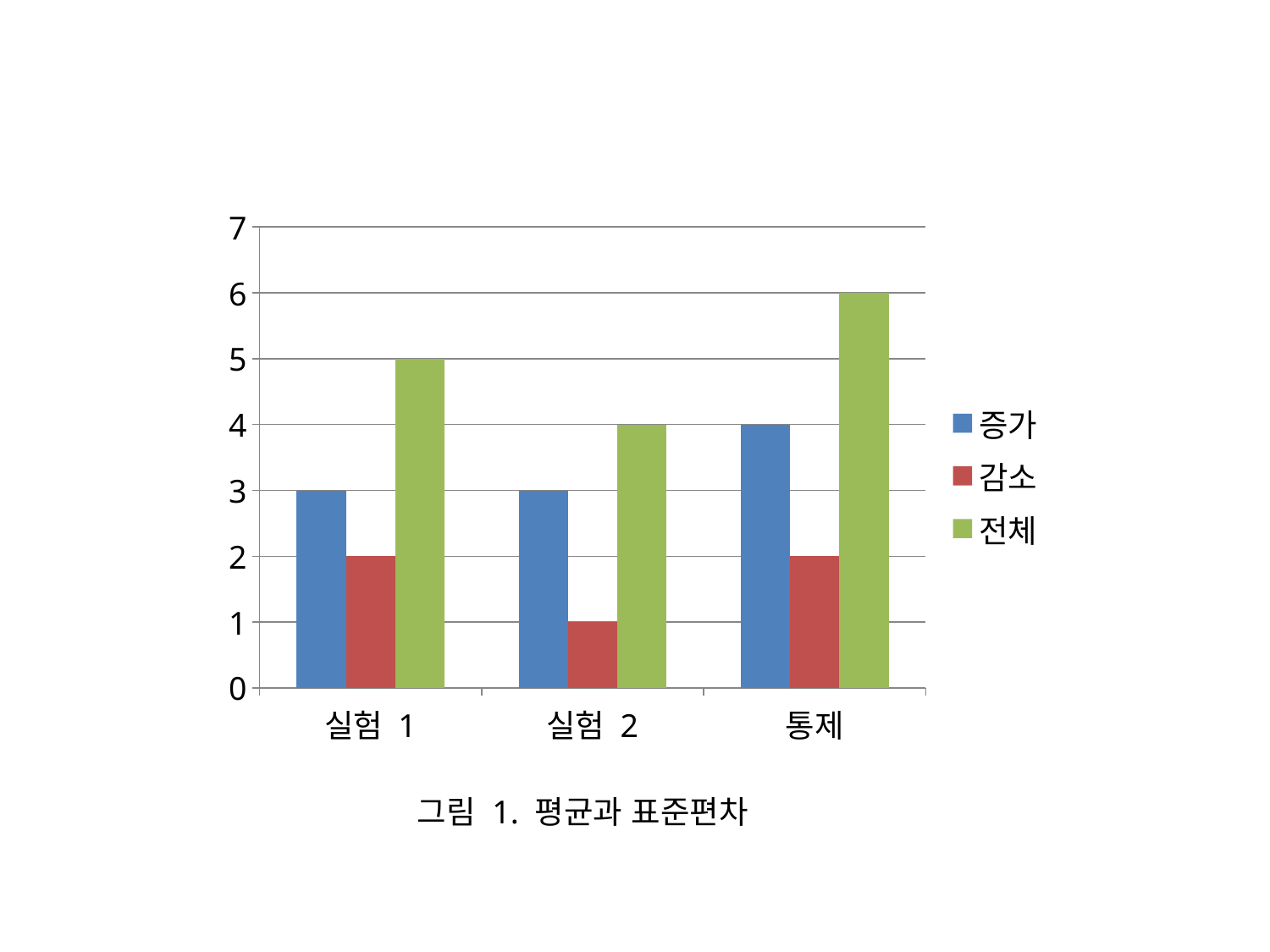
What is the difference between the 전체 values for 통제 and 실험 2? 2 Is the 전체 value for 실험 1 greater or less than 4? greater Which category has the lowest 감소 value? 실험 2 How many series does the legend list? 3 How many categories are shown on the x axis? 3 What is the value of 감소 for 실험 2? 1 What is the value of 전체 for 통제? 6 What kind of chart is shown on the slide? bar chart What is the value of 증가 for 실험 1? 3 What is the caption below the chart? 그림 1. 평균과 표준편차 Which is larger, the 증가 value for 통제 or the 증가 value for 실험 2? 통제 Which category has the highest 전체 value? 통제